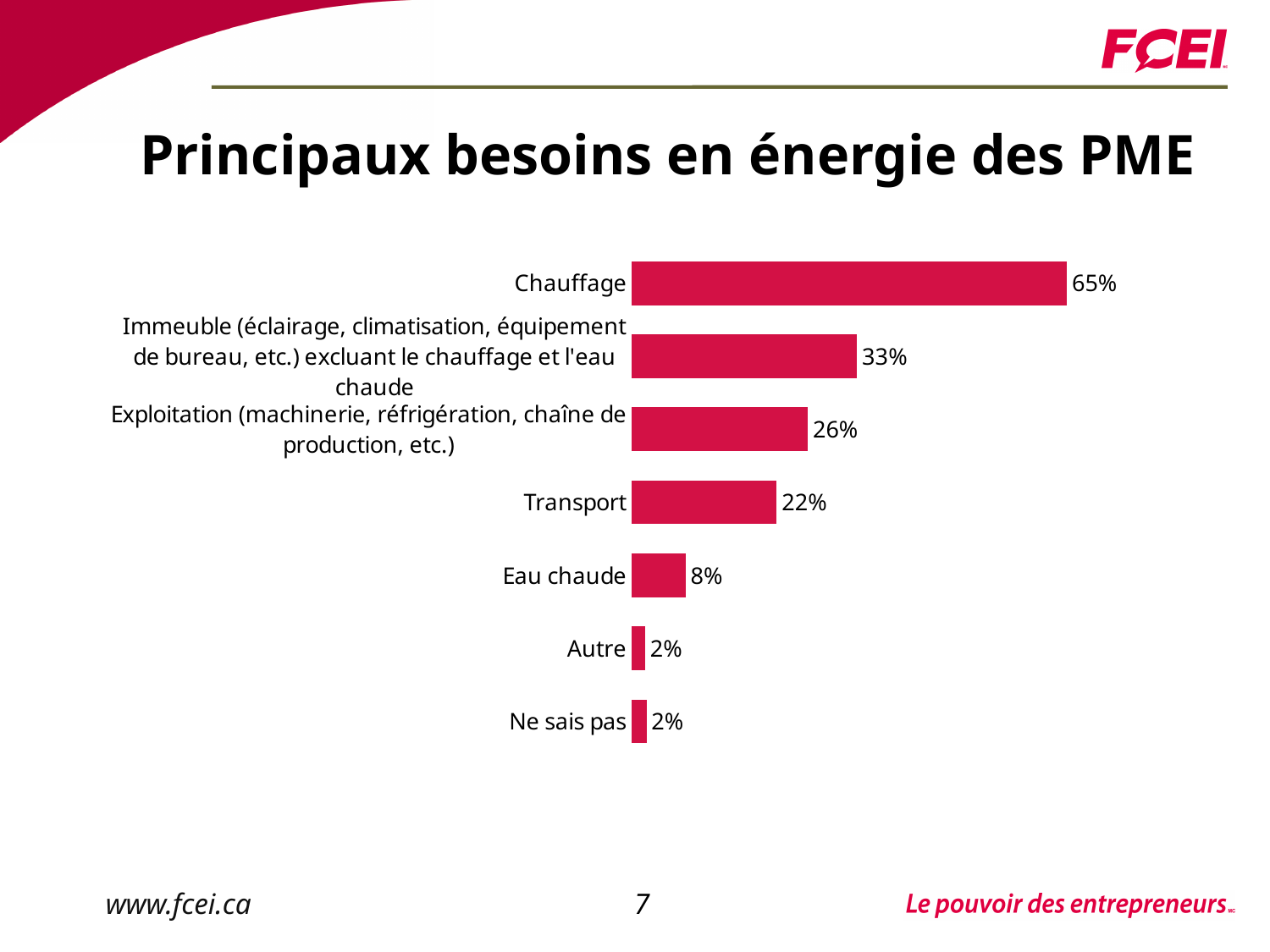
What is the difference between the values for Immeuble (éclairage, climatisation, équipement de bureau, etc.) excluant le chauffage et l'eau chaude and Exploitation (machinerie, réfrigération, chaîne de production, etc.)? 7% What kind of chart is shown on the slide? Bar chart What is the title of the slide? Principaux besoins en énergie des PME What is the difference between the values for Chauffage and Transport? 43% What is the value for Ne sais pas? 2% How many categories are shown in the chart? 7 What is the value for Transport? 22% What is the value for Exploitation (machinerie, réfrigération, chaîne de production, etc.)? 26% Which is larger, the value for Transport or the value for Eau chaude? Transport What is the value for Eau chaude? 8% What is the value for Chauffage? 65% Which category has the highest value? Chauffage